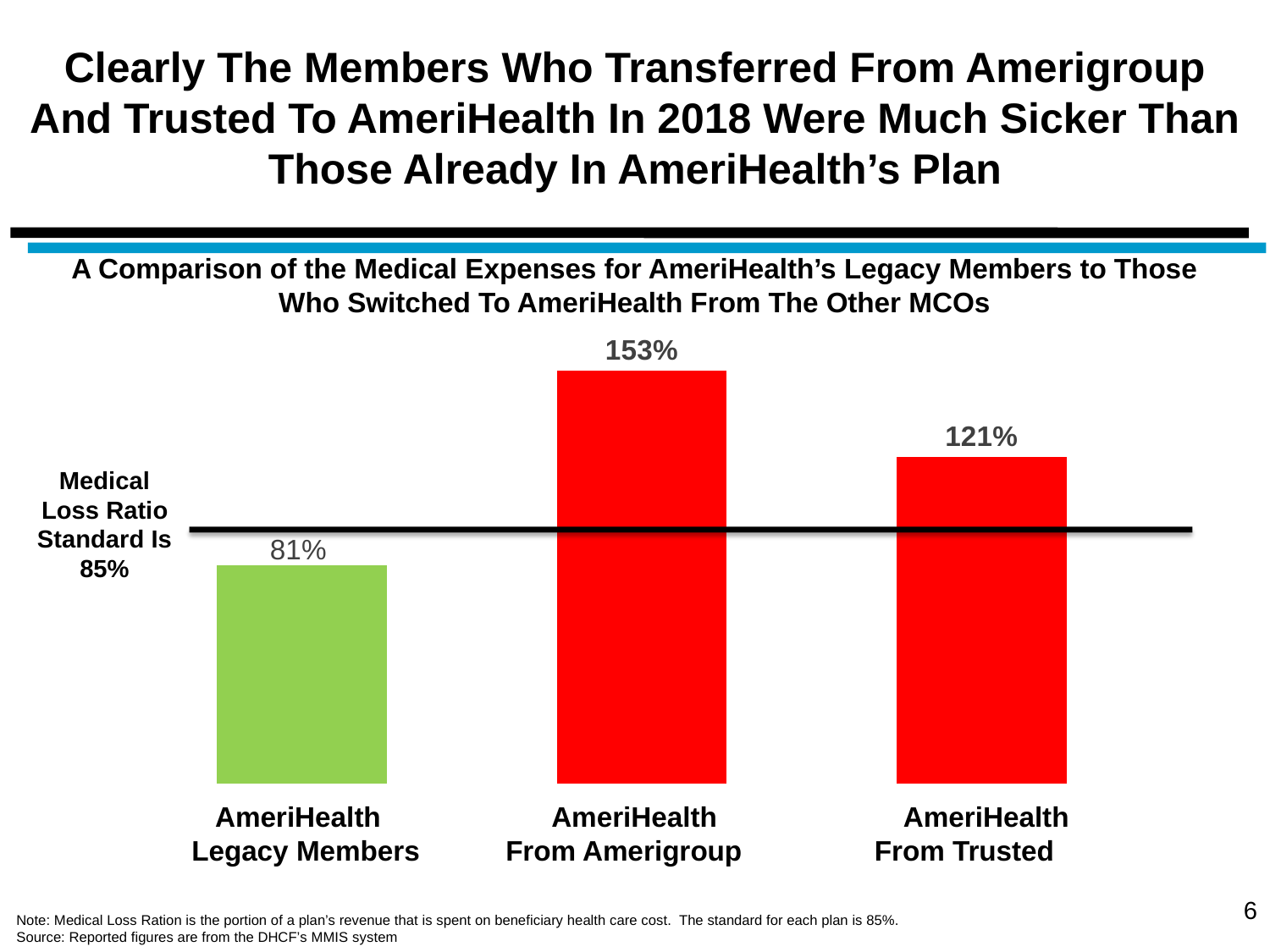
What Medical Loss Ratio standard is marked by the horizontal line on the chart? 85% What is the difference between the values for AmeriHealth From Trusted and AmeriHealth Legacy Members? 40% Which is larger, the value for AmeriHealth From Trusted or AmeriHealth Legacy Members? AmeriHealth From Trusted What colour is the bar for AmeriHealth Legacy Members? Green What is the value for AmeriHealth Legacy Members? 81% What is the value for AmeriHealth From Trusted? 121% How many categories are shown in the chart? 3 What kind of chart is shown on the slide? Bar chart What is the difference between the values for AmeriHealth From Amerigroup and AmeriHealth From Trusted? 32% What is the value for AmeriHealth From Amerigroup? 153% Which category has the lowest value? AmeriHealth Legacy Members Which category has the highest value? AmeriHealth From Amerigroup